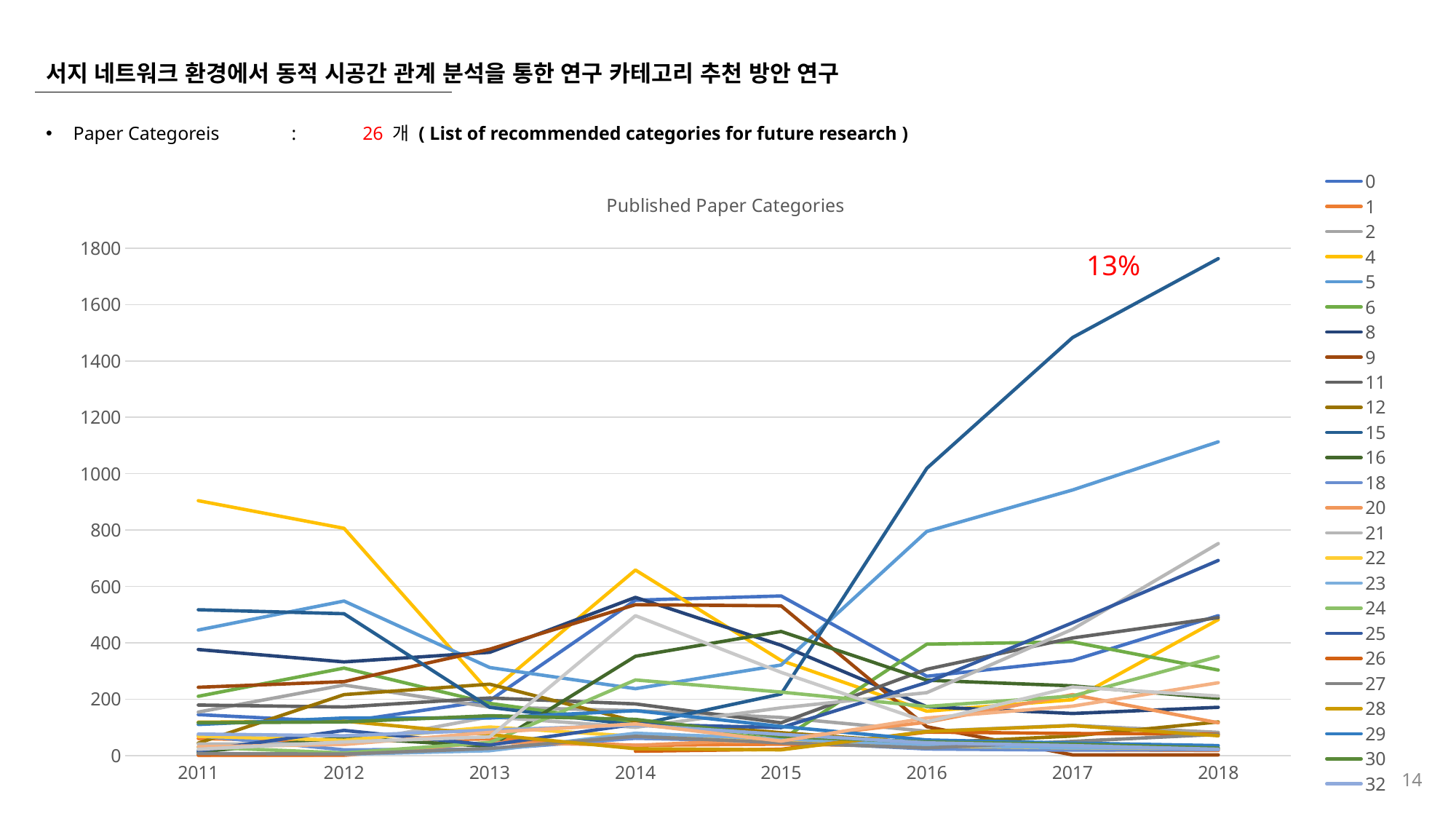
What is the first year shown on the x axis of the chart? 2011 What kind of chart is shown on the slide? line chart Is the highest value plotted in 2013 greater or less than 600? less Which is larger: the highest value plotted in 2018 or the highest value plotted in 2011? 2018 What is the title of the chart? Published Paper Categories What is the last year shown on the x axis of the chart? 2018 What percentage is written in red next to the top of the chart? 13% Does the topmost line rise or fall between 2016 and 2018? rises How many years are plotted along the x axis of the chart? 8 Which year has the highest single plotted value in the chart? 2018 Is the highest value plotted in 2018 greater or less than 1600? greater Is the highest value plotted in 2011 greater or less than 800? greater